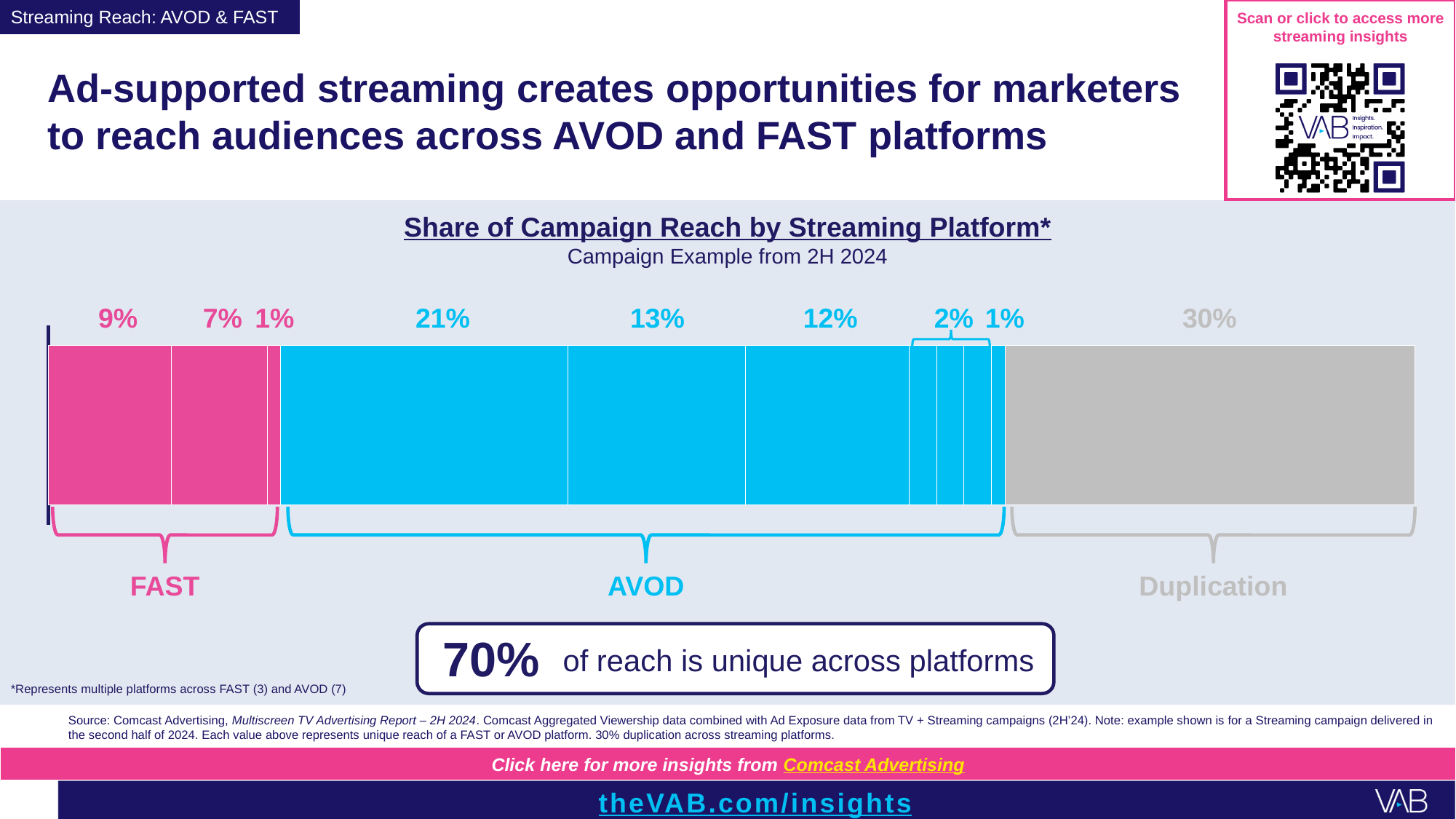
What is the title of the chart? Share of Campaign Reach by Streaming Platform* What is the combined share of the FAST segments (9%, 7% and 1%)? 17% What kind of chart is shown on the slide? Stacked bar chart Which group accounts for a larger share of campaign reach, FAST or AVOD? AVOD What share of campaign reach is labelled as Duplication? 30% What is the largest segment value within the FAST group? 9% How many groups (FAST, AVOD, Duplication) are labelled beneath the bar? 3 What is the largest segment value within the AVOD group? 21% What is the largest single segment value shown in the bar? 30% What is the difference between the largest AVOD segment (21%) and the largest FAST segment (9%)? 12 percentage points How many segments make up the stacked bar? 11